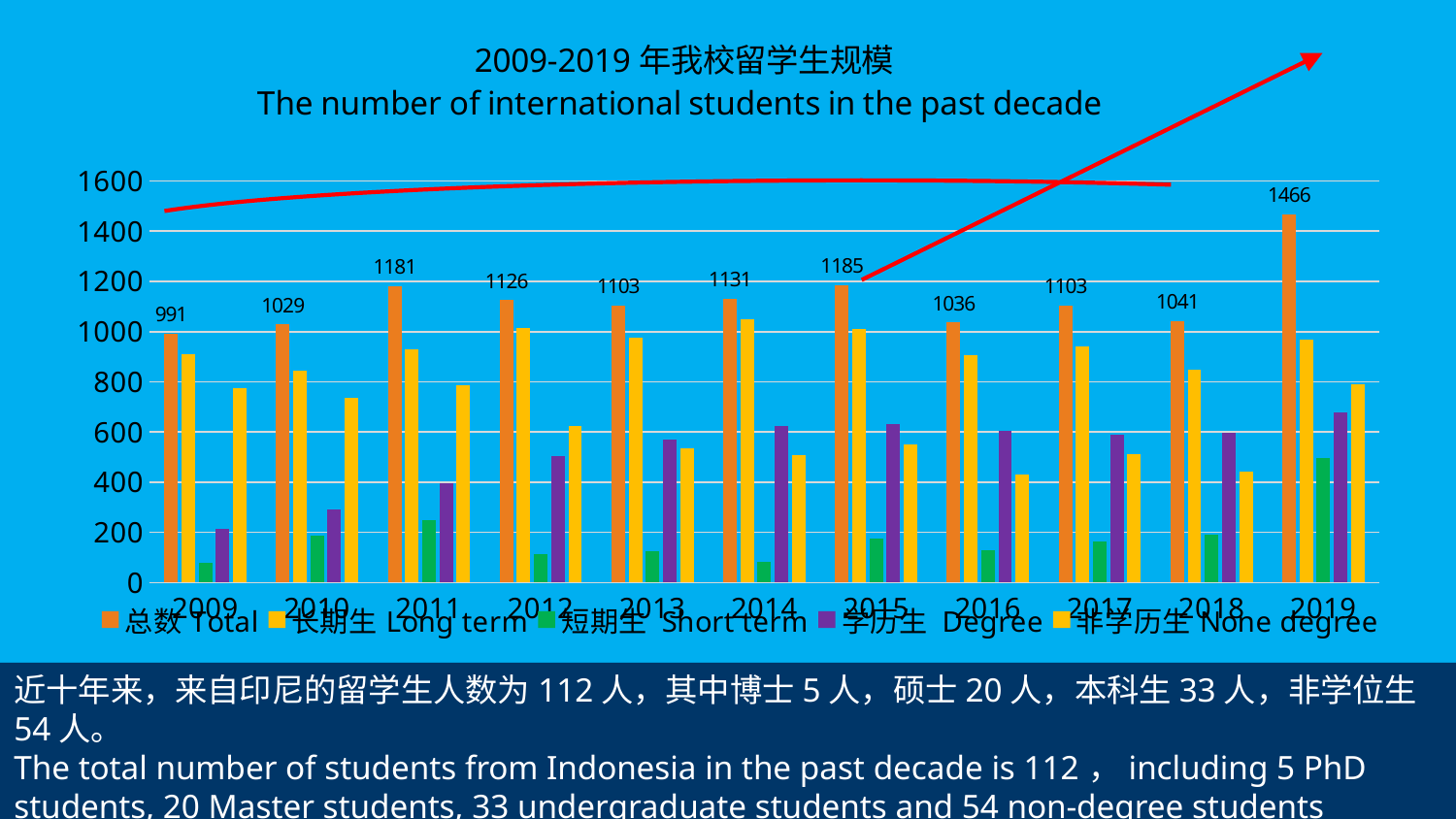
Is the Degree (学历生) value for 2009 greater or less than 400? less Which year has a larger Total value, 2011 or 2015? 2015 What is the Total (总数) value for 2015? 1185 How many series does the legend list? 5 Which year has the lowest Total (总数) value? 2009 What kind of chart is shown on the slide? bar chart What is the Total (总数) value for 2009? 991 Which year has the highest Total (总数) value? 2019 What is the Total (总数) value for 2019? 1466 What is the difference between the Total values for 2019 and 2009? 475 Is the Long term (长期生) value for 2009 greater or less than 800? greater How many years are shown on the x axis? 11